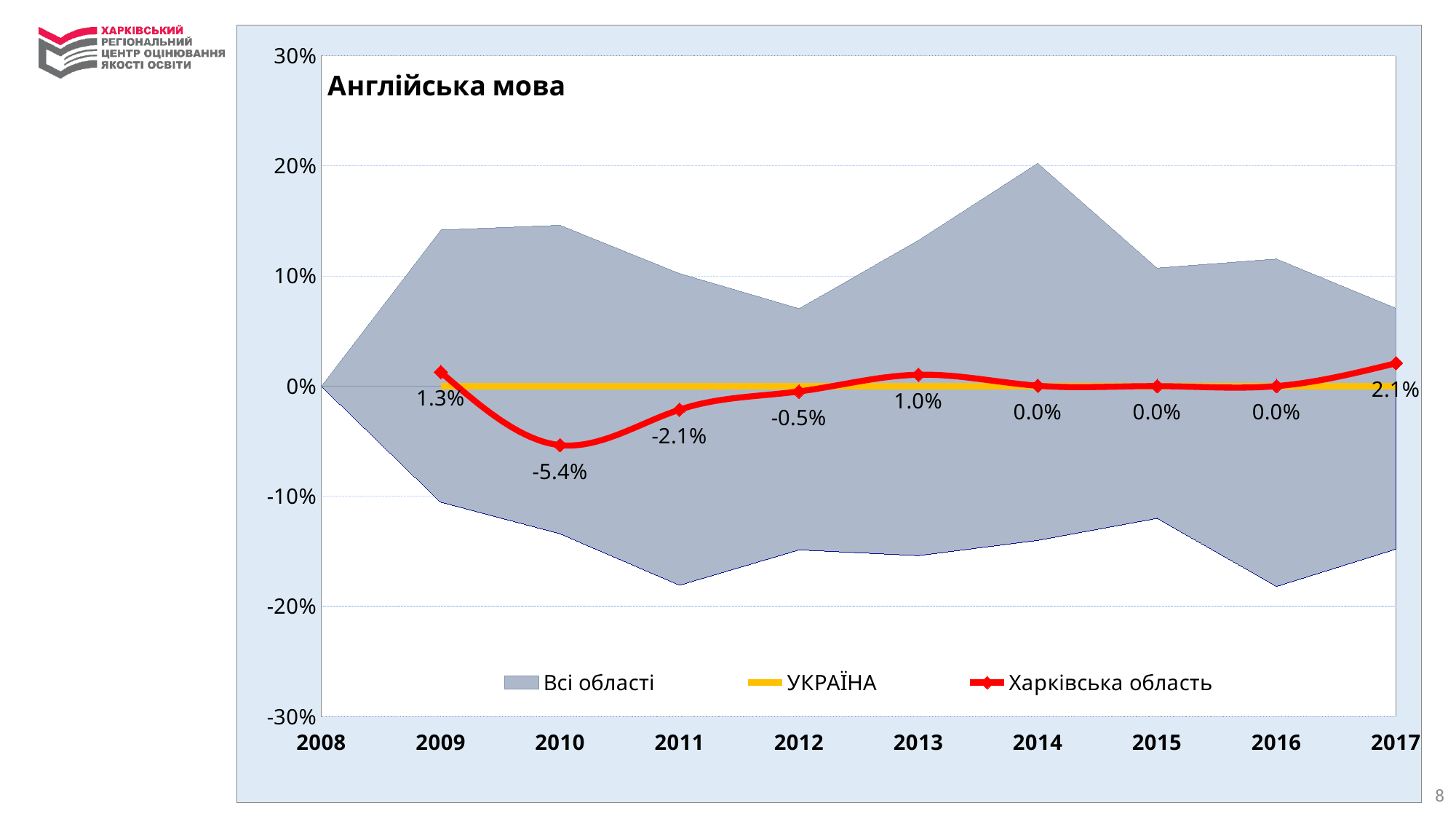
In which year is the value for Харківська область highest? 2017 What is the value for Харківська область in 2010? -5.4% In which year is the value for Харківська область lowest? 2010 How many data points are labelled for Харківська область? 9 What is the title of the chart? Англійська мова What is the difference between the Харківська область values for 2017 and 2009? 0.8 percentage points What is the value for Харківська область in 2012? -0.5% Which is larger for Харківська область: the value in 2013 or the value in 2011? 2013 What is the value for Харківська область in 2017? 2.1% Is the upper edge of the Всі області area in 2014 greater or less than 10%? greater How many series does the legend list? 3 Does the value for Харківська область rise or fall from 2010 to 2013? rise